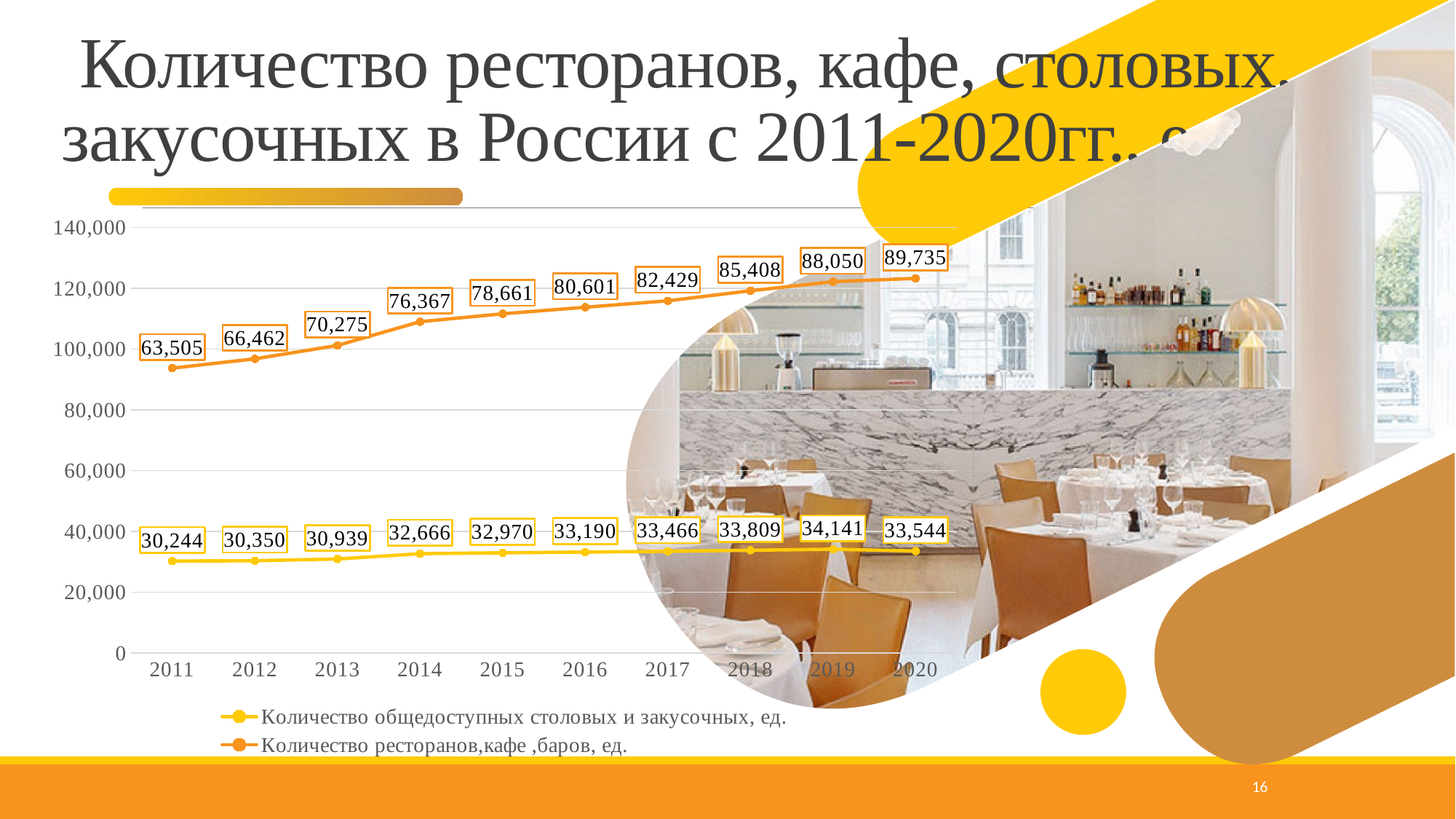
In which year is the series "Количество ресторанов,кафе ,баров, ед." highest? 2020 How many years are shown on the x axis of the chart? 10 What is the value for 2020 in the series "Количество ресторанов,кафе ,баров, ед."? 89,735 How many series does the legend list? 2 In which year is the series "Количество общедоступных столовых и закусочных, ед." lowest? 2011 What is the value for 2014 in the series "Количество общедоступных столовых и закусочных, ед."? 32,666 Which is larger: the 2016 value of "Количество ресторанов,кафе ,баров, ед." or the 2016 value of "Количество общедоступных столовых и закусочных, ед."? Количество ресторанов,кафе ,баров, ед. What kind of chart is shown on the slide? Line chart What is the value for 2011 in the series "Количество ресторанов,кафе ,баров, ед."? 63,505 What is the value for 2019 in the series "Количество общедоступных столовых и закусочных, ед."? 34,141 What is the difference between the 2019 and 2020 values of the series "Количество общедоступных столовых и закусочных, ед."? 597 What is the difference between the 2020 and 2011 values of the series "Количество ресторанов,кафе ,баров, ед."? 26,230